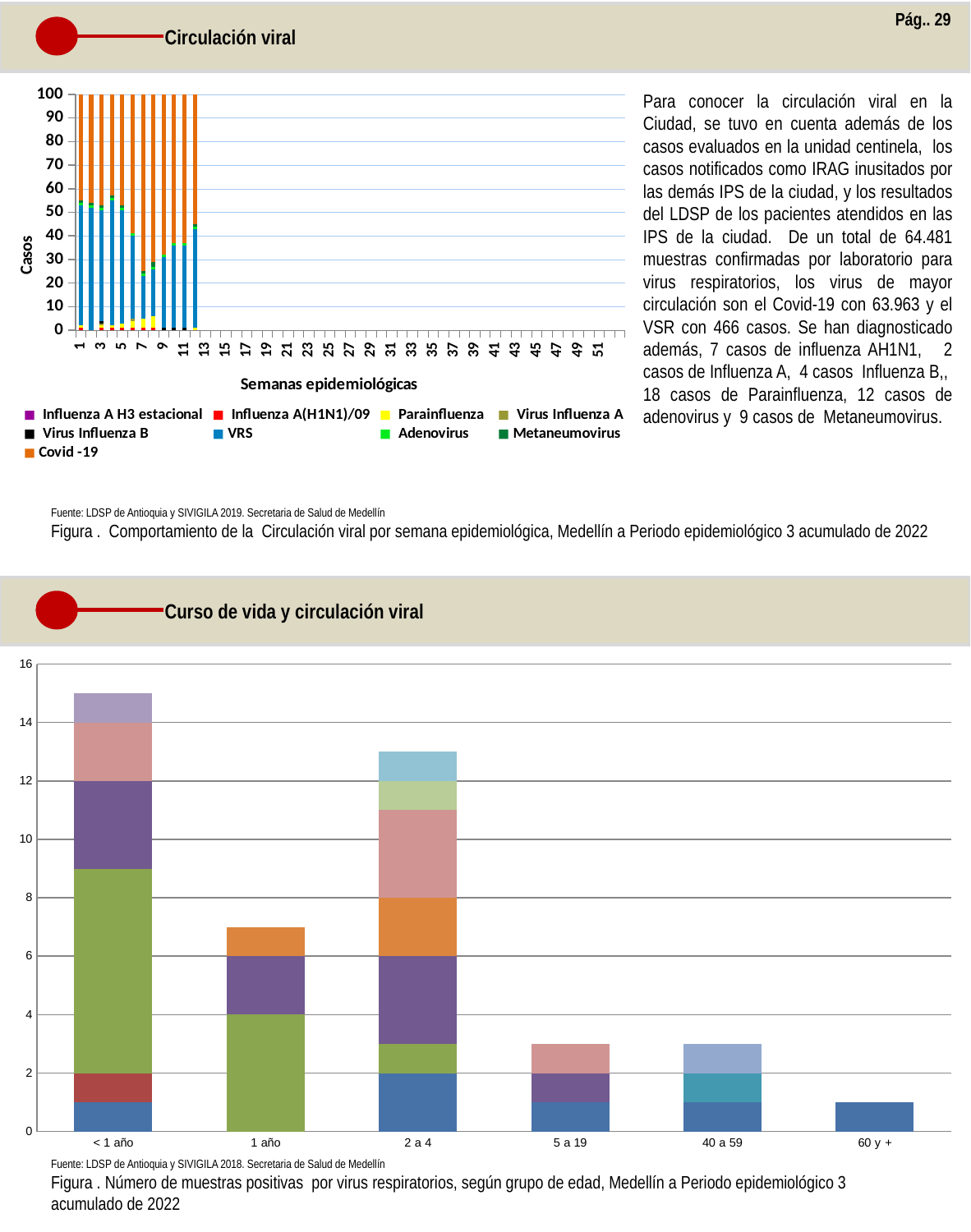
In the bottom chart (Curso de vida y circulación viral), which stacked bar is taller, 1 año or 2 a 4? 2 a 4 What kind of chart is the top chart (Circulación viral)? Stacked bar chart In the top chart (Circulación viral), what is the title of the x axis? Semanas epidemiológicas In the top chart (Circulación viral), how many series does the legend list? 9 In the top chart (Circulación viral), how many epidemiological weeks have a bar plotted? 12 In the bottom chart (Curso de vida y circulación viral), which age group has the tallest stacked bar? < 1 año In the bottom chart (Curso de vida y circulación viral), which age group has the shortest stacked bar? 60 y + In the bottom chart (Curso de vida y circulación viral), is the total for 5 a 19 greater or less than 4? less In the bottom chart (Curso de vida y circulación viral), how many age-group categories are shown on the x axis? 6 In the top chart (Circulación viral), what is the total height of the stacked bar for week 1? 100 In the top chart (Circulación viral), what is the title of the y axis? Casos In the bottom chart (Curso de vida y circulación viral), is the total for < 1 año greater or less than 14? greater